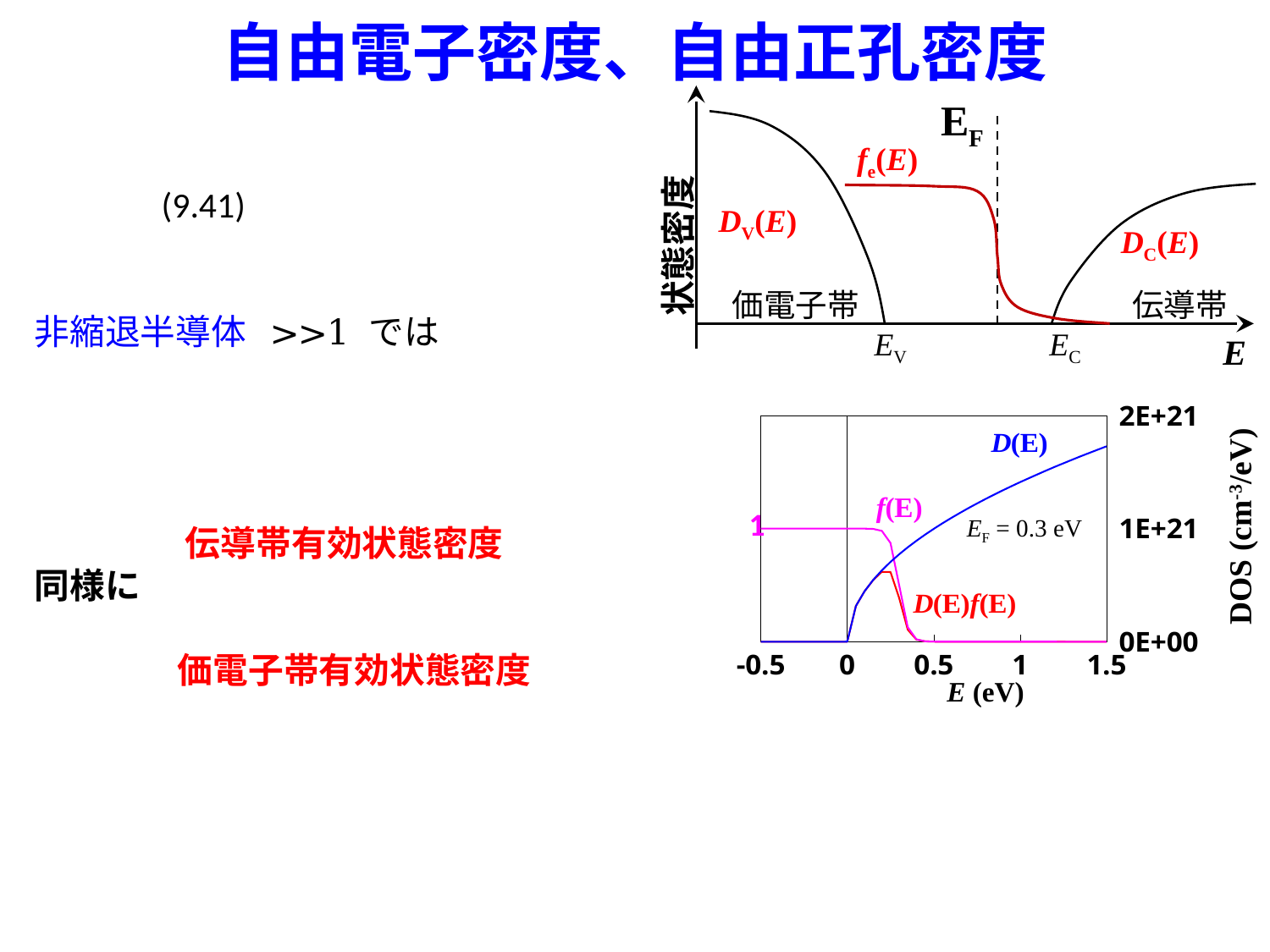
In the bottom chart, what is the highest tick value shown on the DOS axis? 2E+21 In the bottom chart, what is the label on the horizontal axis? E (eV) In the bottom chart, which curve has the highest value at E = 1.5 eV? D(E) In the top chart, what is the label on the vertical axis? 状態密度 In the bottom chart, what is the value of f(E) at E = -0.5 eV, as labelled on the plot? 1 What kind of chart is the bottom chart (DOS versus E)? line chart In the bottom chart, is the value of D(E) at E = 1 eV greater or less than 1E+21? greater In the bottom chart, is the value of D(E) at E = 1.5 eV greater or less than 1E+21? greater In the bottom chart, does D(E) rise or fall as E increases from 0 to 1.5 eV? rises In the bottom chart, how many curves are plotted? 3 In the top chart, does D_C(E) rise or fall as E increases beyond E_C? rises In the bottom chart, what value of the Fermi energy E_F is printed on the plot? E_F = 0.3 eV